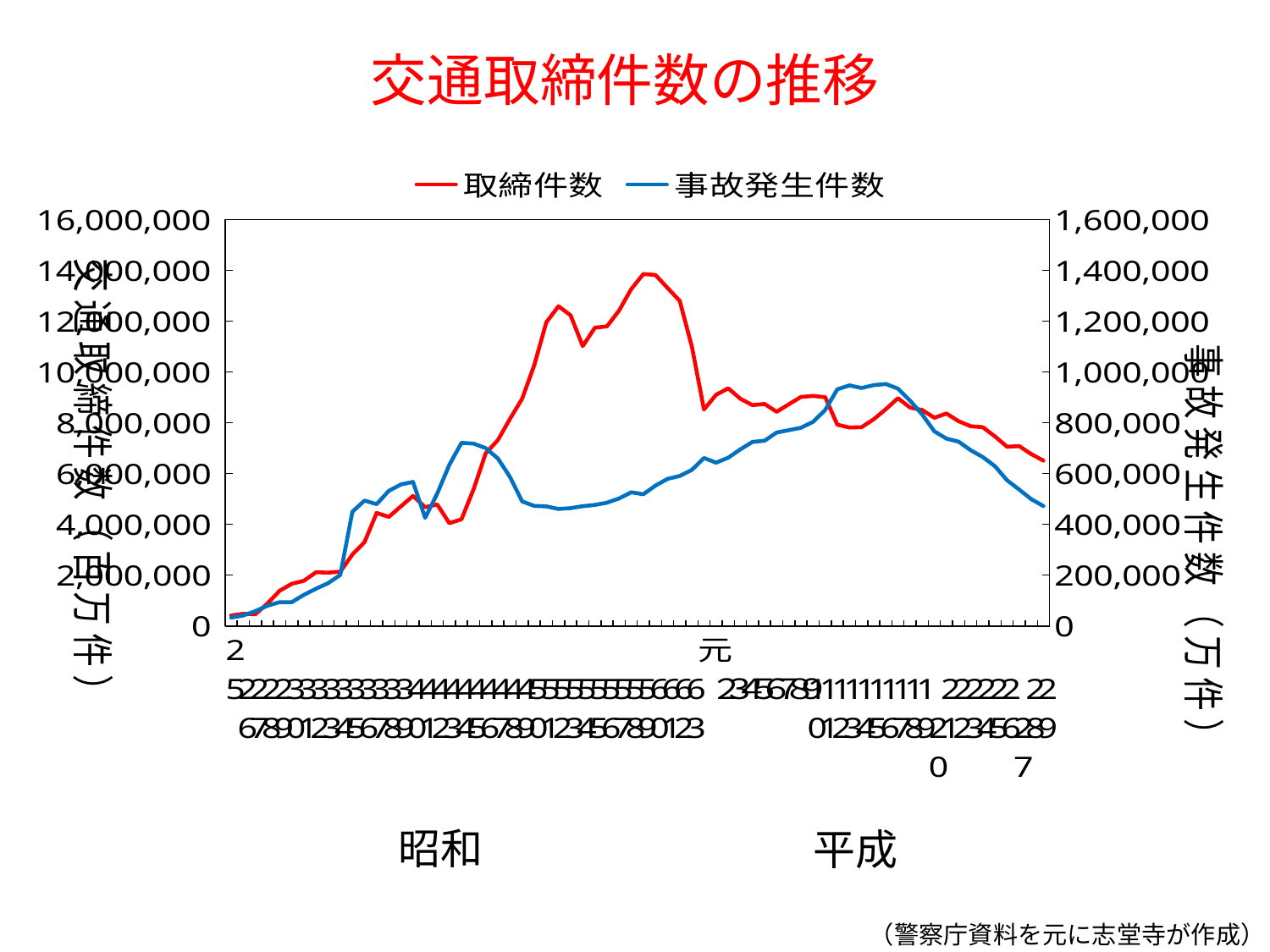
What is the maximum value shown on the left vertical axis? 16,000,000 Is the value of the 事故発生件数 line at the right end of the chart greater or less than 600,000 on the right axis? less Does the 事故発生件数 line rise or fall over the final years at the right end of the chart? fall What kind of chart is shown on the slide? line chart What is the maximum value shown on the right vertical axis? 1,600,000 Does the 取締件数 line rise or fall over the first years at the left end of the chart? rise How many series does the legend list? 2 Is the peak value of the 事故発生件数 line greater or less than 800,000 on the right axis? greater Is the value of the 取締件数 line at the right end of the chart greater or less than 8,000,000 on the left axis? less Which series is drawn in red? 取締件数 What is the title of the chart? 交通取締件数の推移